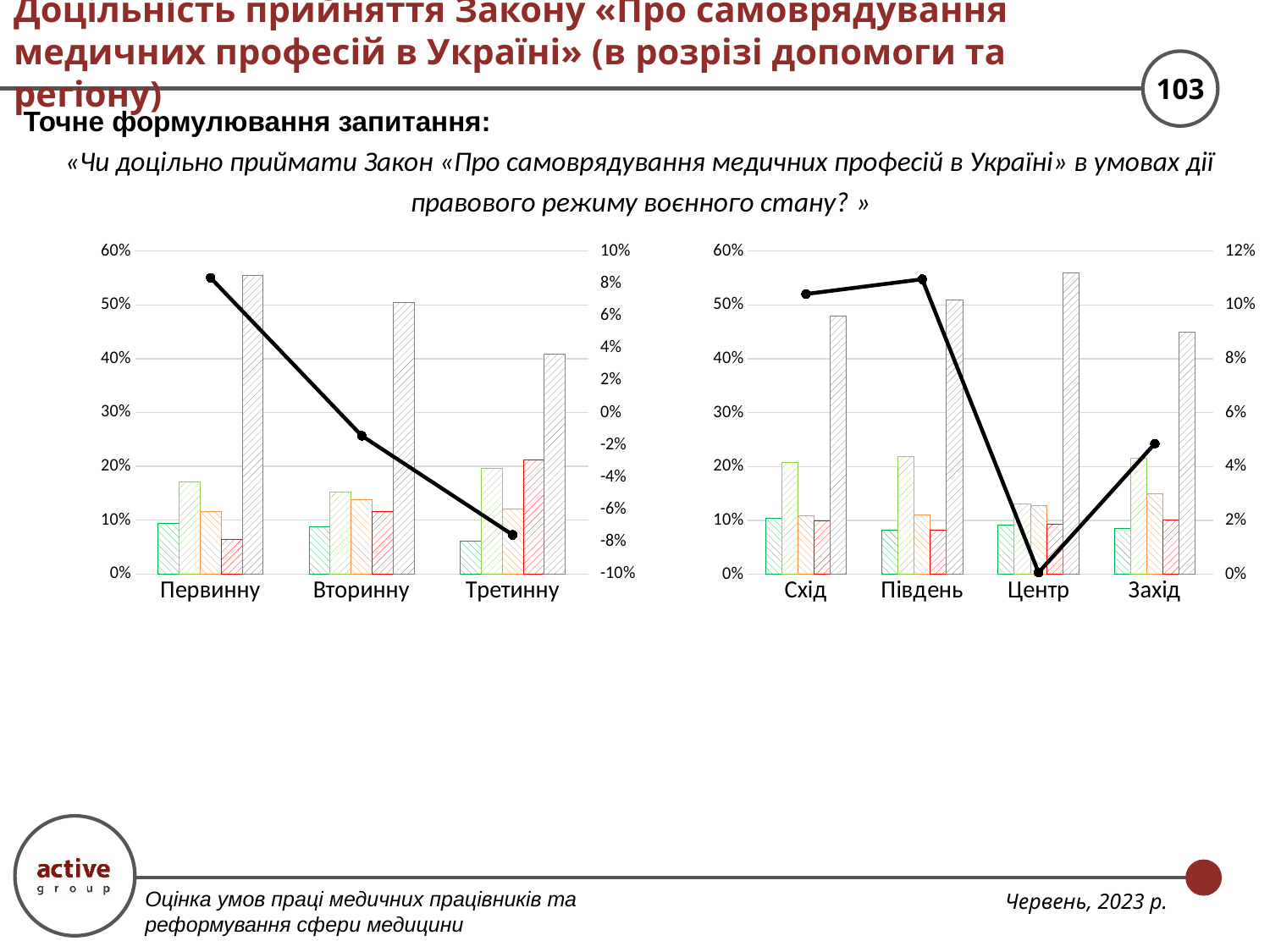
In the left chart, which category has the highest value on the black line? Первинну In the left chart, does the black line rise or fall from Первинну to Третинну? falls In the left chart, is the tallest (grey hatched) bar for Первинну greater or less than 50%? greater In the left chart, is the black line value for Третинну greater or less than 0%? less In the right chart (Схід, Південь, Центр, Захід), how many categories are shown on the x axis? 4 In the left chart (Первинну, Вторинну, Третинну), how many categories are shown on the x axis? 3 In the right chart, which category has the lowest value on the black line? Центр In the right chart, is the tallest (grey hatched) bar for Захід greater or less than 50%? less In the right chart, which category has the tallest grey hatched bar? Центр What is the top value shown on the right-hand axis of the right chart? 12% What kind of chart is the left chart? Bar chart combined with a line